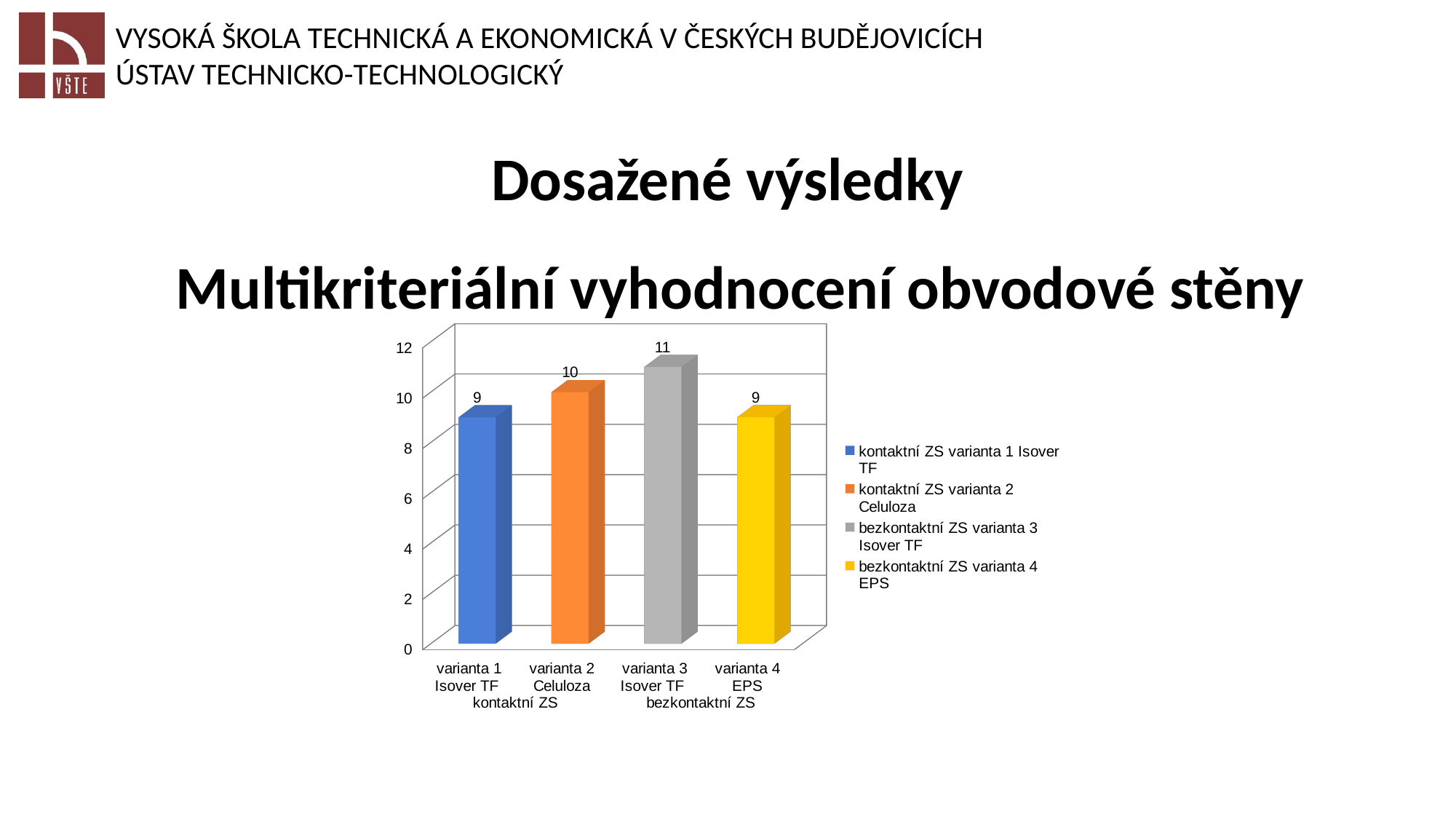
How many bars are plotted in the chart? 4 What is the difference between the values for varianta 3 Isover TF and varianta 1 Isover TF? 2 What is the value for varianta 1 Isover TF? 9 What kind of chart is shown on the slide? bar chart Is the value for varianta 3 Isover TF greater or less than 10? greater Which variant has the highest value? varianta 3 Isover TF How many entries does the legend list? 4 Which is larger, the value for varianta 2 Celuloza or the value for varianta 4 EPS? varianta 2 Celuloza What is the value for varianta 4 EPS? 9 What is the difference between the values for varianta 2 Celuloza and varianta 4 EPS? 1 What is the value for varianta 3 Isover TF? 11 What is the value for varianta 2 Celuloza? 10